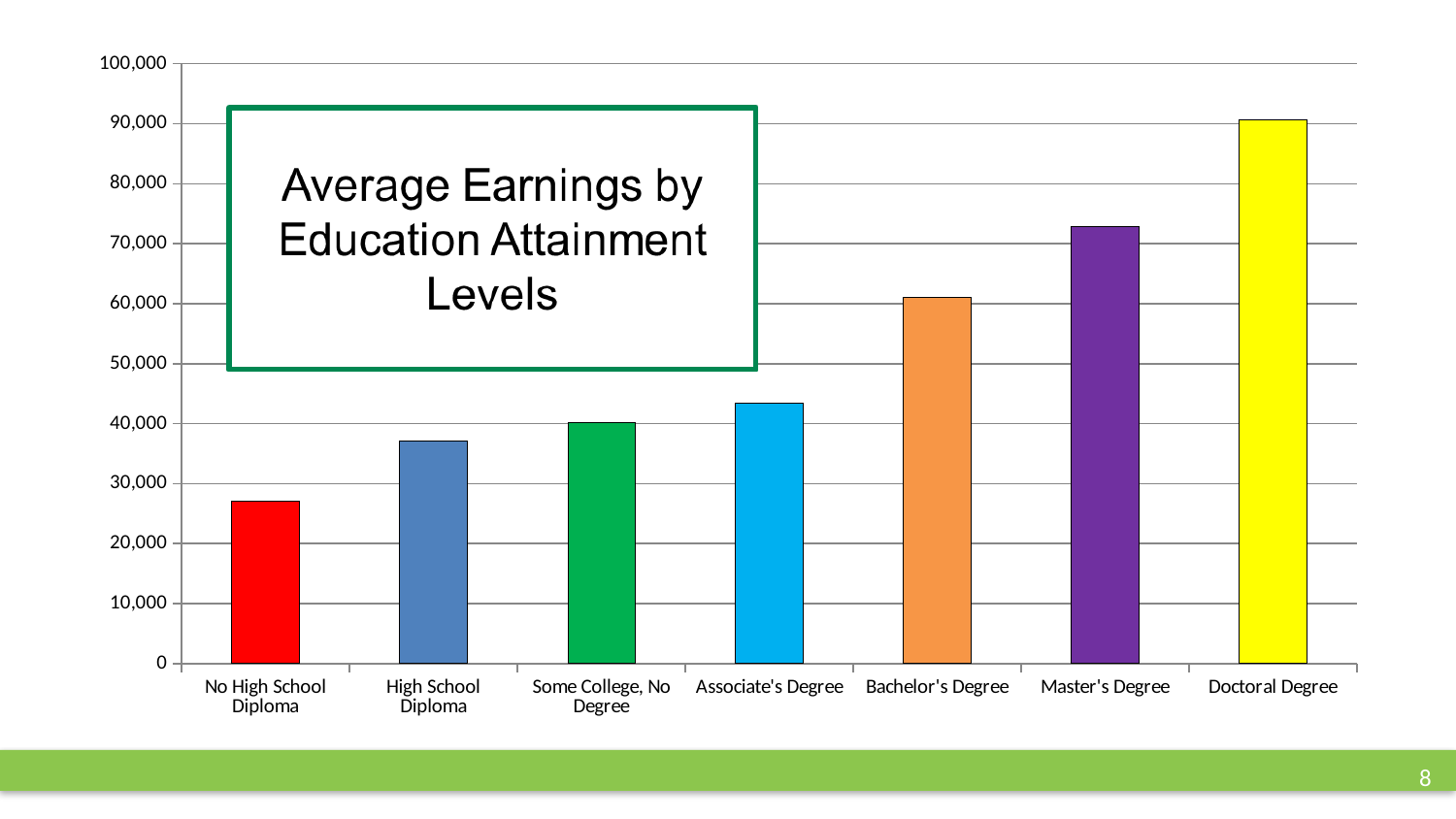
Which education level has the lowest average earnings? No High School Diploma Is the value for No High School Diploma greater or less than 30,000? less Which has higher average earnings, Master's Degree or Bachelor's Degree? Master's Degree Is the value for High School Diploma greater or less than 40,000? less How many education attainment categories are shown on the x axis? 7 Is the value for Doctoral Degree greater or less than 80,000? greater What is the title of the chart? Average Earnings by Education Attainment Levels What type of chart is shown on the slide? Bar chart Which education level has the highest average earnings? Doctoral Degree Do the average earnings rise or fall as you move from left to right along the x axis? Rise